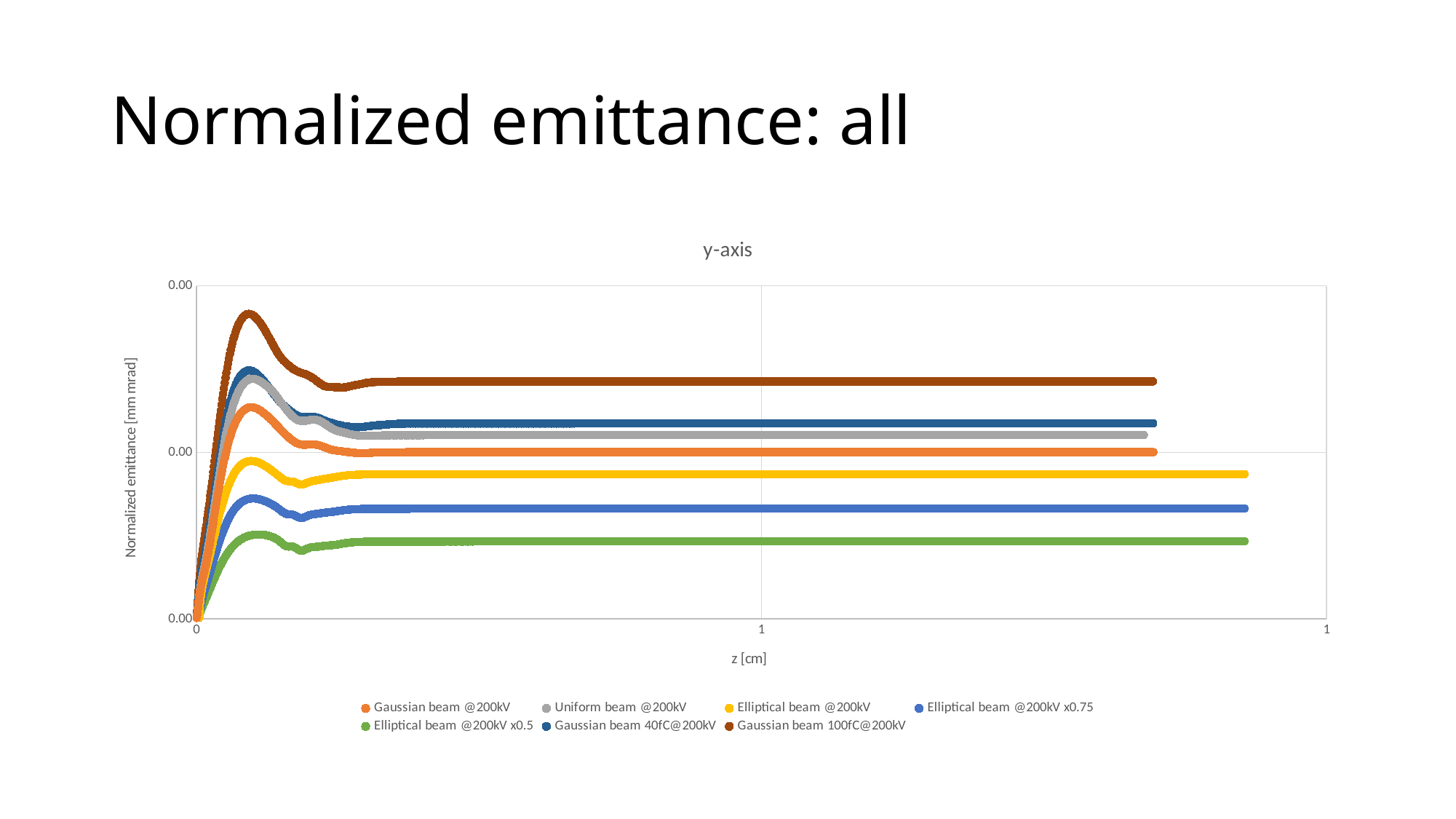
Do the values of the Gaussian beam 100fC@200kV series rise or fall at the start of the x axis, near z = 0? Rise Which series has the lowest normalized emittance values? Elliptical beam @200kV x0.5 Which series has a higher peak: Gaussian beam 100fC@200kV or Uniform beam @200kV? Gaussian beam 100fC@200kV What is the label of the y axis? Normalized emittance [mm mrad] Which series has a lower plateau value: Elliptical beam @200kV x0.75 or Elliptical beam @200kV? Elliptical beam @200kV x0.75 What kind of chart is shown on the slide? Line chart What is the label of the x axis? z [cm] Which series has a higher plateau value: Gaussian beam 40fC@200kV or Elliptical beam @200kV? Gaussian beam 40fC@200kV Which series reaches the highest normalized emittance values? Gaussian beam 100fC@200kV How many series does the legend list? 7